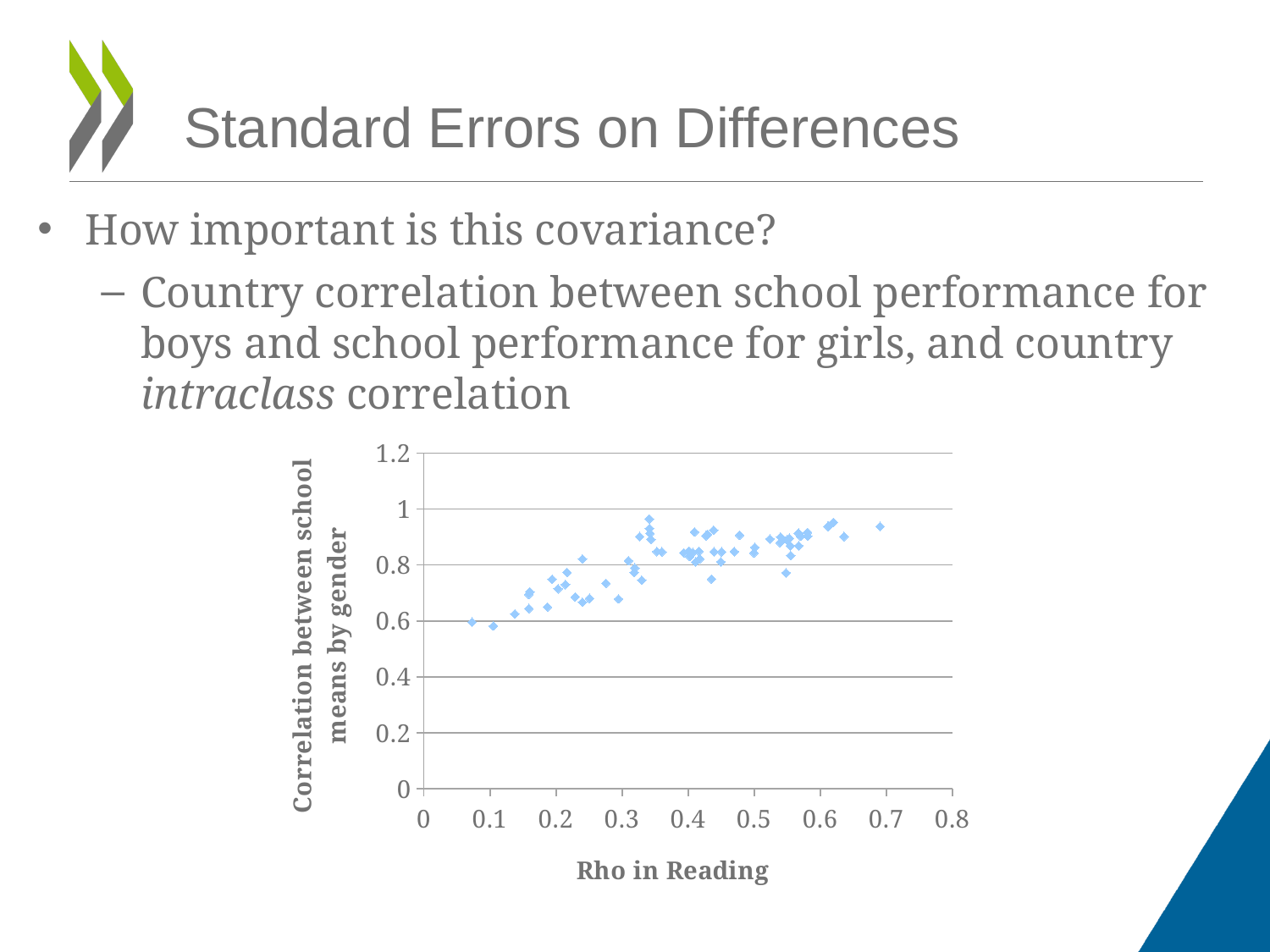
Are all the plotted points greater or less than 1 on the y axis? less What is the highest tick value shown on the y axis? 1.2 What is the title of the y axis of the chart? Correlation between school means by gender What is the highest tick value shown on the x axis? 0.8 Is the point with the smallest Rho in Reading value greater or less than 0.1 on the x axis? less What is the interval between consecutive tick marks on the x axis? 0.1 What is the title of the x axis of the chart? Rho in Reading Are all the plotted points greater or less than 0.4 on the y axis? greater What kind of chart is shown on the slide? scatter plot As Rho in Reading increases along the x axis, do the plotted correlation values generally rise or fall? rise